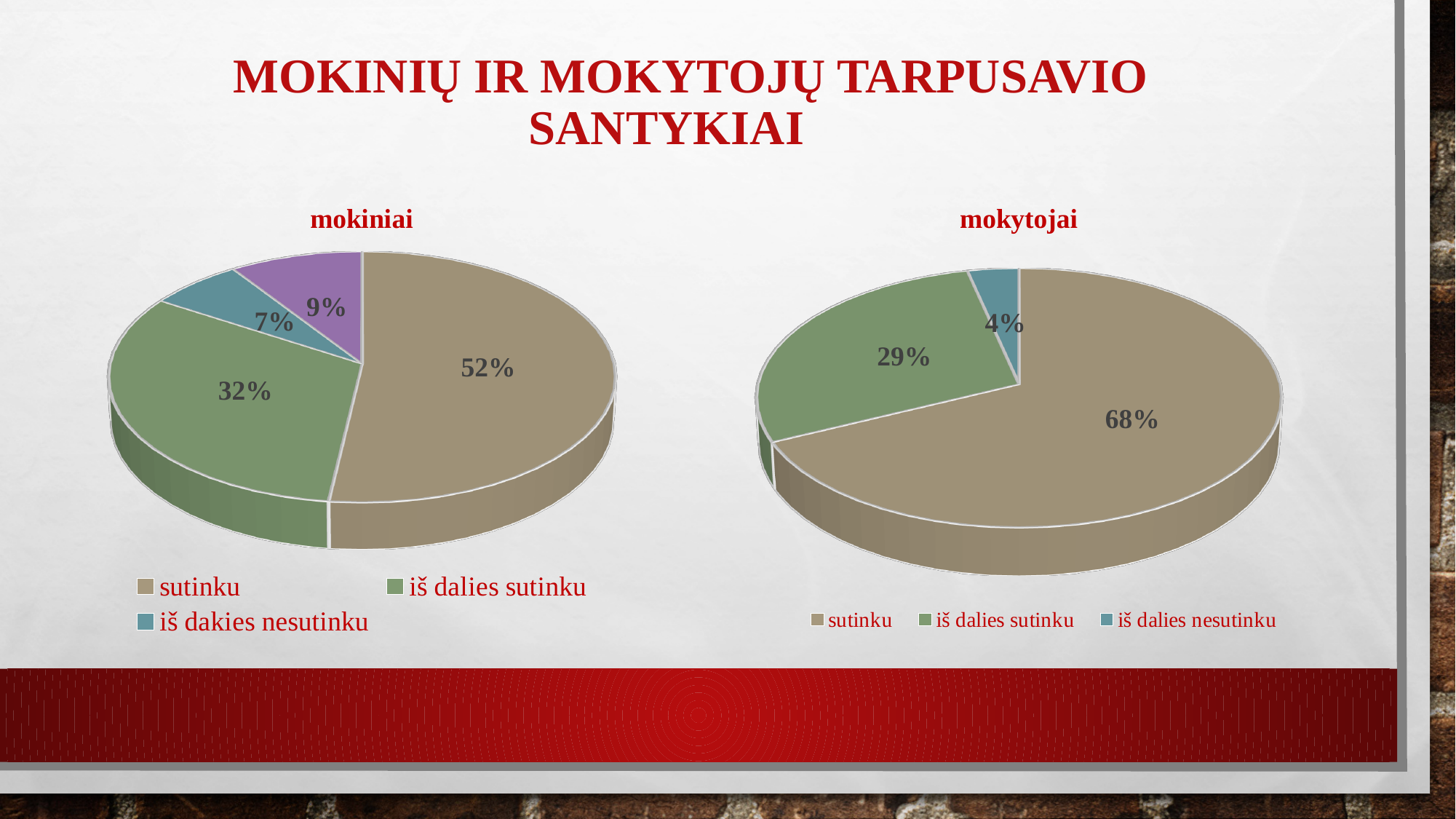
In the "mokytojai" chart, which category has the largest share? sutinku Which is larger: "sutinku" in the "mokiniai" chart or "sutinku" in the "mokytojai" chart? mokytojai In the "mokiniai" chart, what percentage is shown for "iš dakies nesutinku"? 7% In the "mokytojai" chart, what percentage is shown for "sutinku"? 68% In the "mokiniai" chart, what percentage is shown for "iš dalies sutinku"? 32% In the "mokytojai" chart, which category has the smallest share? iš dalies nesutinku In the "mokytojai" chart, what percentage is shown for "iš dalies nesutinku"? 4% How many slices does the "mokiniai" chart have? 4 In the "mokiniai" chart, what is the difference in percentage points between "sutinku" and "iš dalies sutinku"? 20 In the "mokytojai" chart, what percentage is shown for "iš dalies sutinku"? 29% In the "mokiniai" chart, what percentage is shown for "sutinku"? 52% What type of chart is the "mokytojai" chart? pie chart